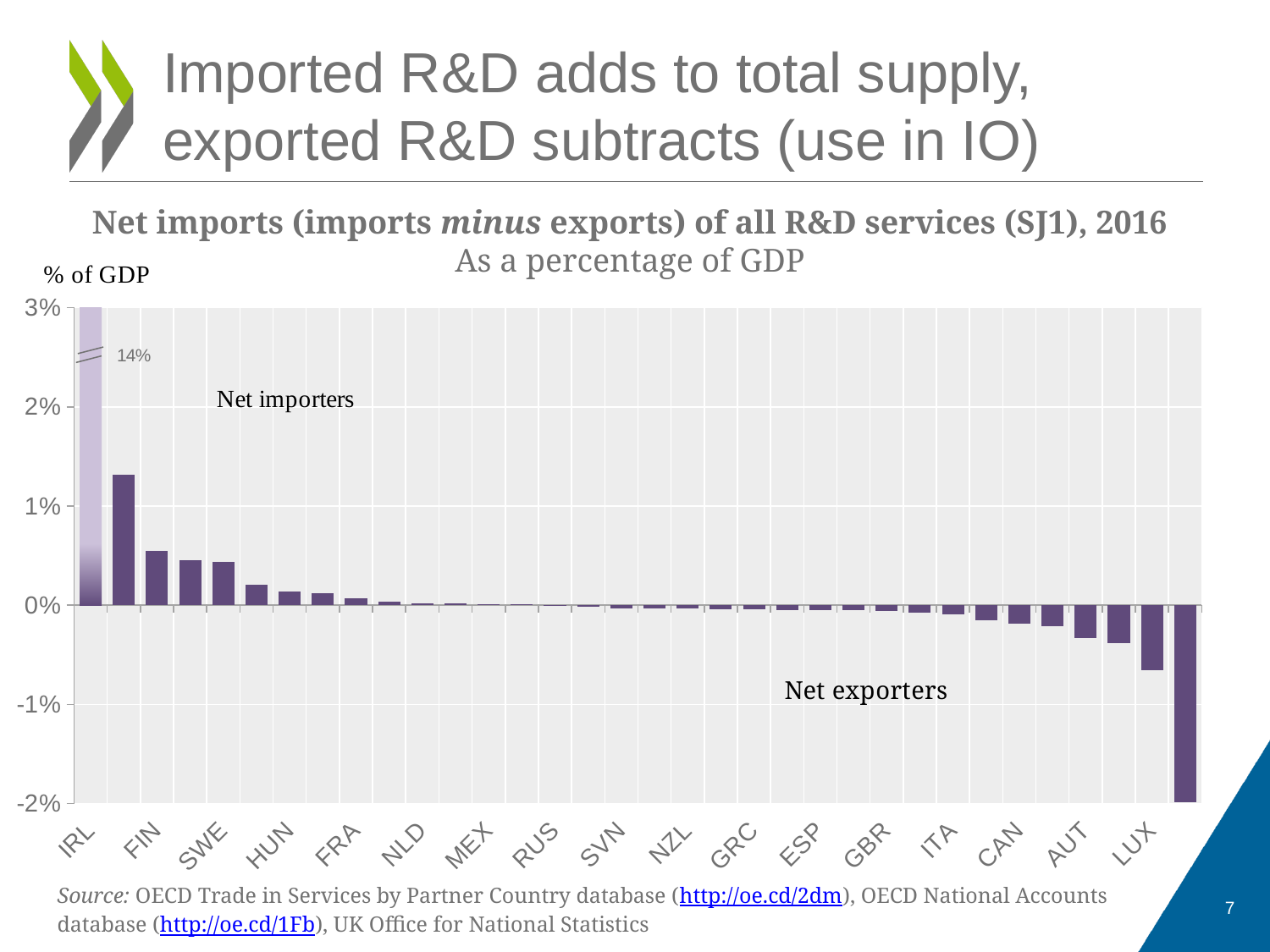
Is the value for LUX greater or less than -1%? greater Which has the larger value, FIN or SWE? FIN Which country has the highest net imports of R&D services as a percentage of GDP? IRL Do the values rise or fall moving from left to right along the x axis? fall What is the label on the vertical axis of the chart? % of GDP Is the value for SWE greater or less than 1%? less How many country labels are shown on the x axis? 17 Is the value for FIN greater or less than 1%? less What kind of chart is shown on the slide? bar chart What is the value shown for IRL? 14%